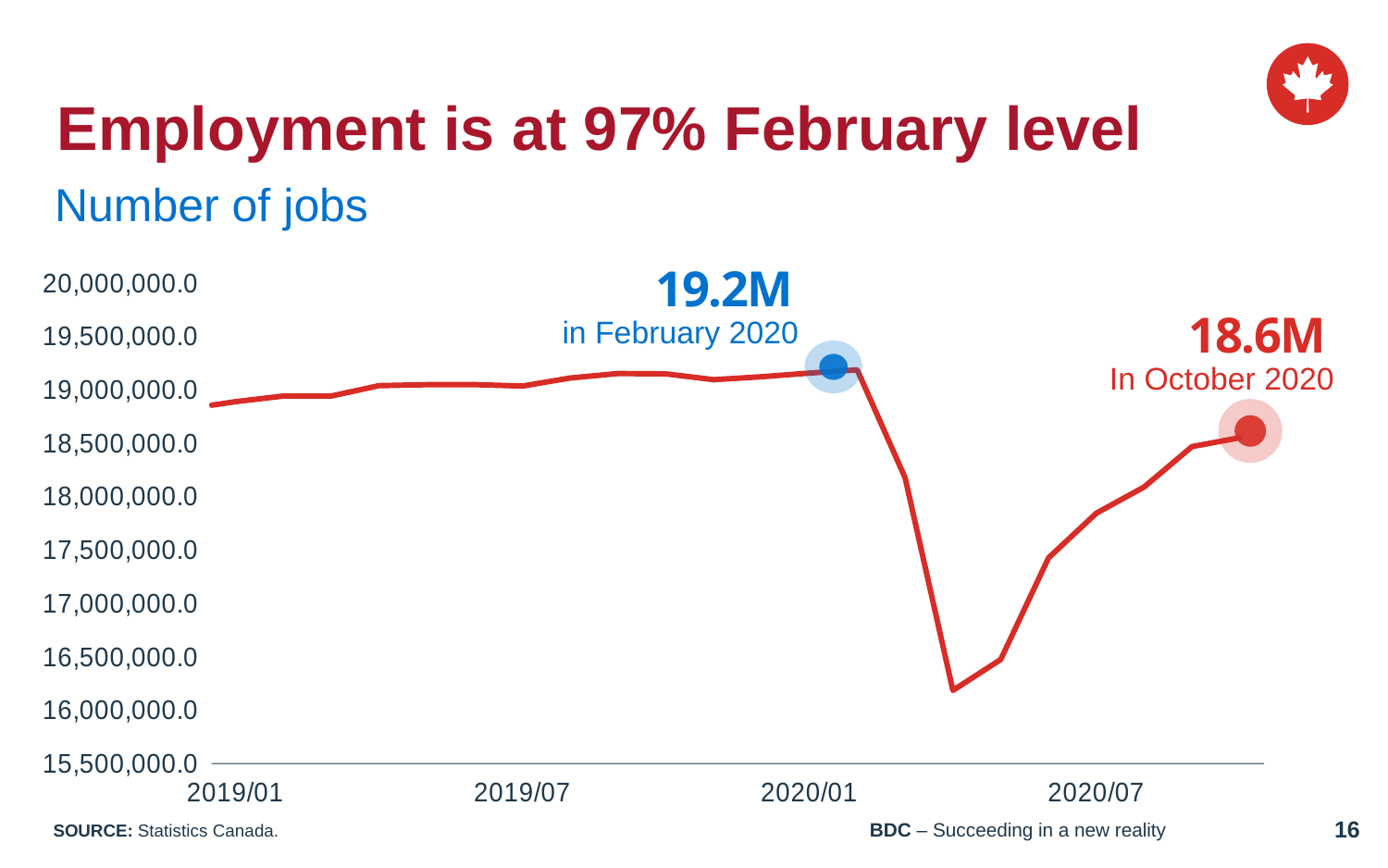
Which is larger, the number of jobs in February 2020 or in October 2020? February 2020 Is the value at 2020/07 greater or less than 17,500,000.0? greater What kind of chart is shown on the slide? Line chart Is the value at 2019/01 greater or less than 18,500,000.0? greater Does the line rise or fall between February 2020 and its lowest point? Fall What was the number of jobs in February 2020, as labelled on the chart? 19.2M How many date labels are shown on the x axis? 4 Does the line rise or fall between its lowest point and October 2020? Rise What was the number of jobs in October 2020, as labelled on the chart? 18.6M What is the difference between the labelled February 2020 value and the labelled October 2020 value? 0.6M Is the lowest point of the line greater or less than 16,500,000.0? less What is the subtitle describing what the chart measures? Number of jobs